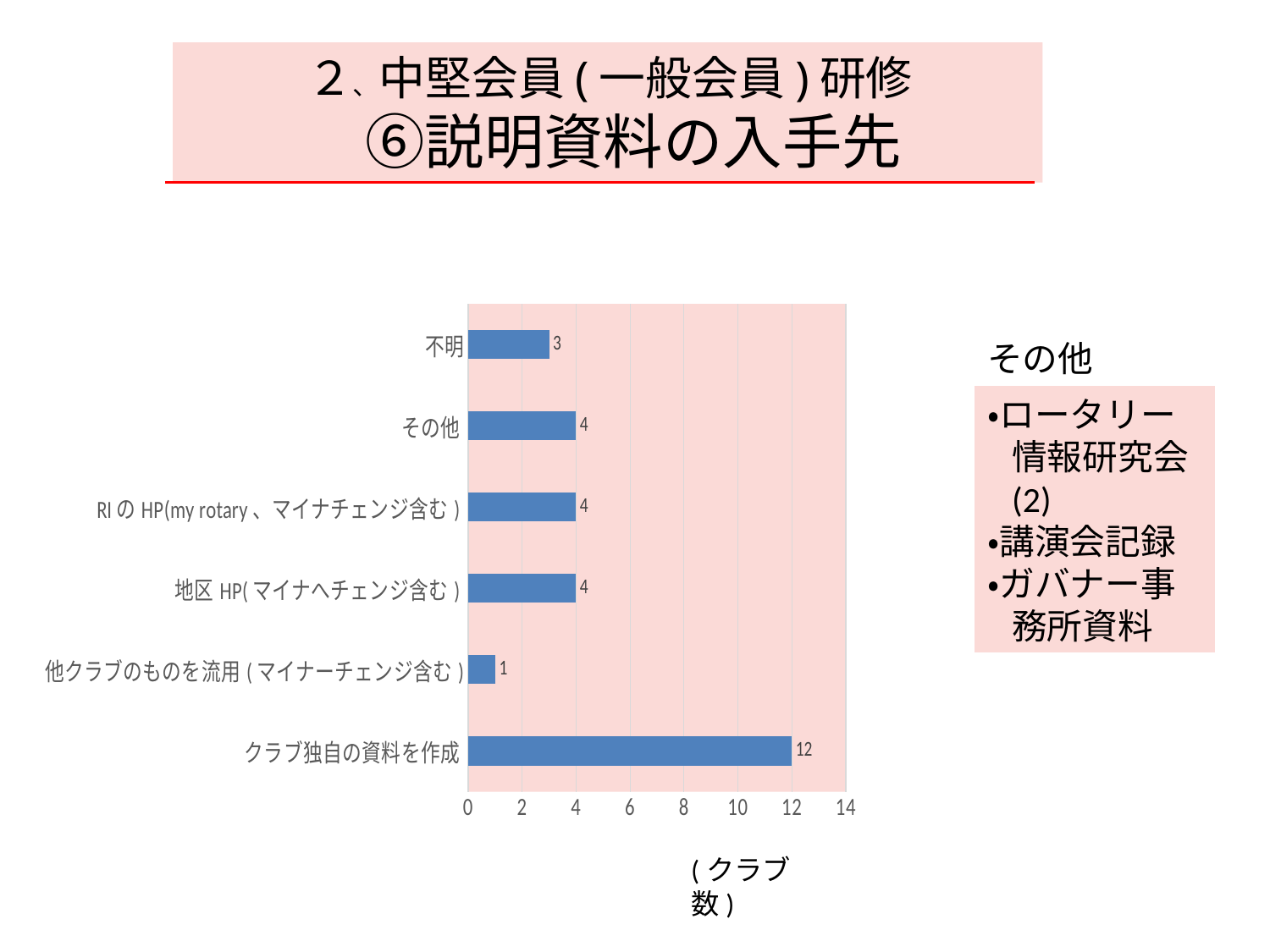
What is the value for 不明? 3 Which category has the lowest value? 他クラブのものを流用(マイナーチェンジ含む) Is the value for クラブ独自の資料を作成 greater or less than 10? greater Which category has the highest value? クラブ独自の資料を作成 What is the value for 他クラブのものを流用(マイナーチェンジ含む)? 1 What is the value for 地区HP(マイナーチェンジ含む)? 4 What is the maximum value shown on the horizontal axis? 14 What is the value for クラブ独自の資料を作成? 12 How many categories are shown in the chart? 6 What kind of chart is shown on the slide? bar chart Which is larger, the value for 不明 or the value for その他? その他 What is the difference between the values for クラブ独自の資料を作成 and その他? 8